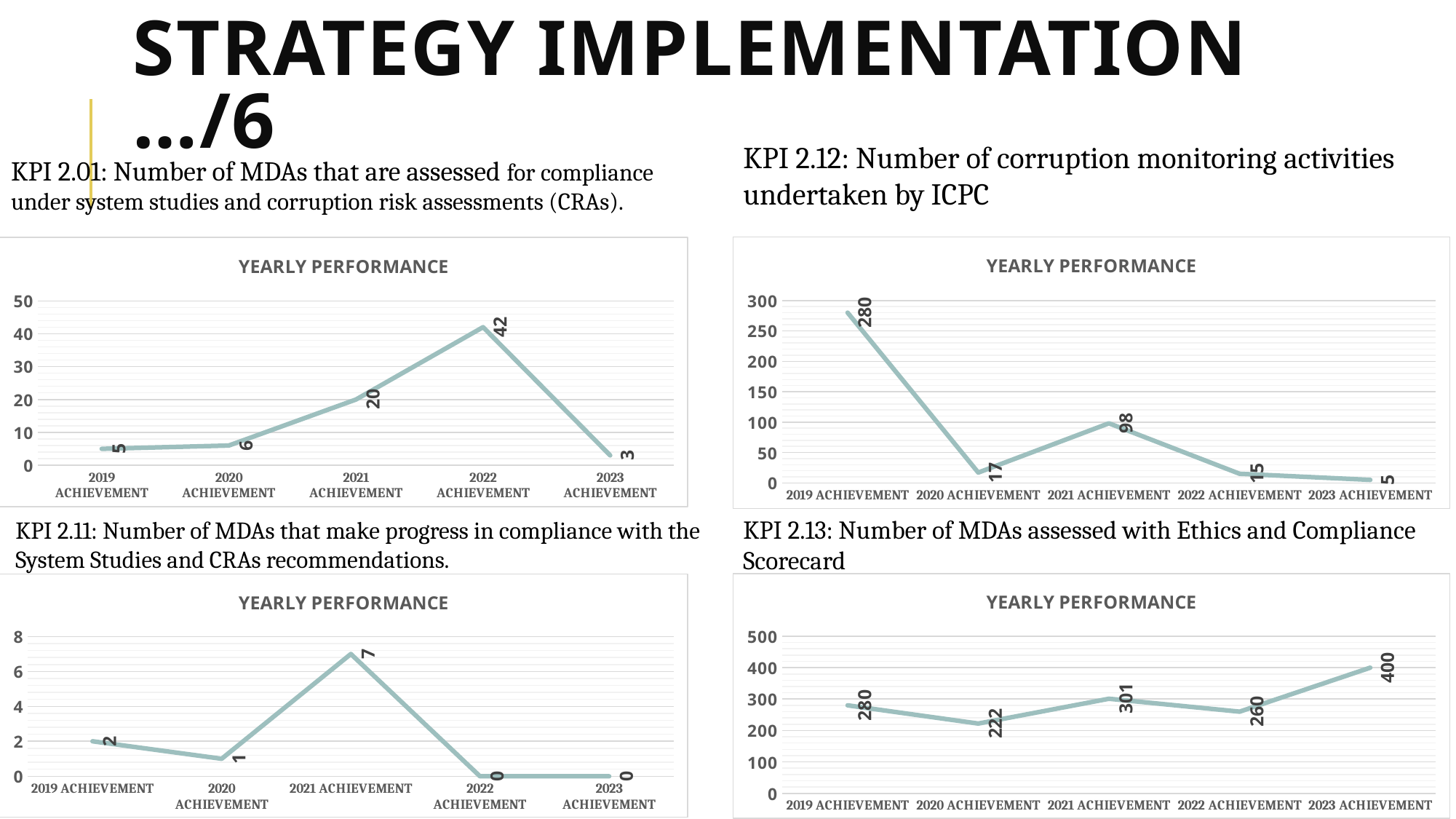
In the KPI 2.12 chart (top right), which year has the highest value? 2019 ACHIEVEMENT In the KPI 2.01 chart (top left), which year has the lowest value? 2023 ACHIEVEMENT What type of chart is used for the KPI 2.13 chart (bottom right)? Line chart In the KPI 2.12 chart (top right), what is the value for 2019 ACHIEVEMENT? 280 In the KPI 2.01 chart (top left), what is the difference between the 2022 and 2021 values? 22 In the KPI 2.11 chart (bottom left), what is the value for 2021 ACHIEVEMENT? 7 In the KPI 2.12 chart (top right), which is larger, the 2020 value or the 2021 value? 2021 ACHIEVEMENT In the KPI 2.13 chart (bottom right), what is the value for 2023 ACHIEVEMENT? 400 In the KPI 2.11 chart (bottom left), how many years are plotted? 5 In the KPI 2.13 chart (bottom right), what is the difference between the 2023 and 2022 values? 140 In the KPI 2.01 chart (top left), what is the value for 2022 ACHIEVEMENT? 42 In the KPI 2.13 chart (bottom right), which year has the lowest value? 2020 ACHIEVEMENT